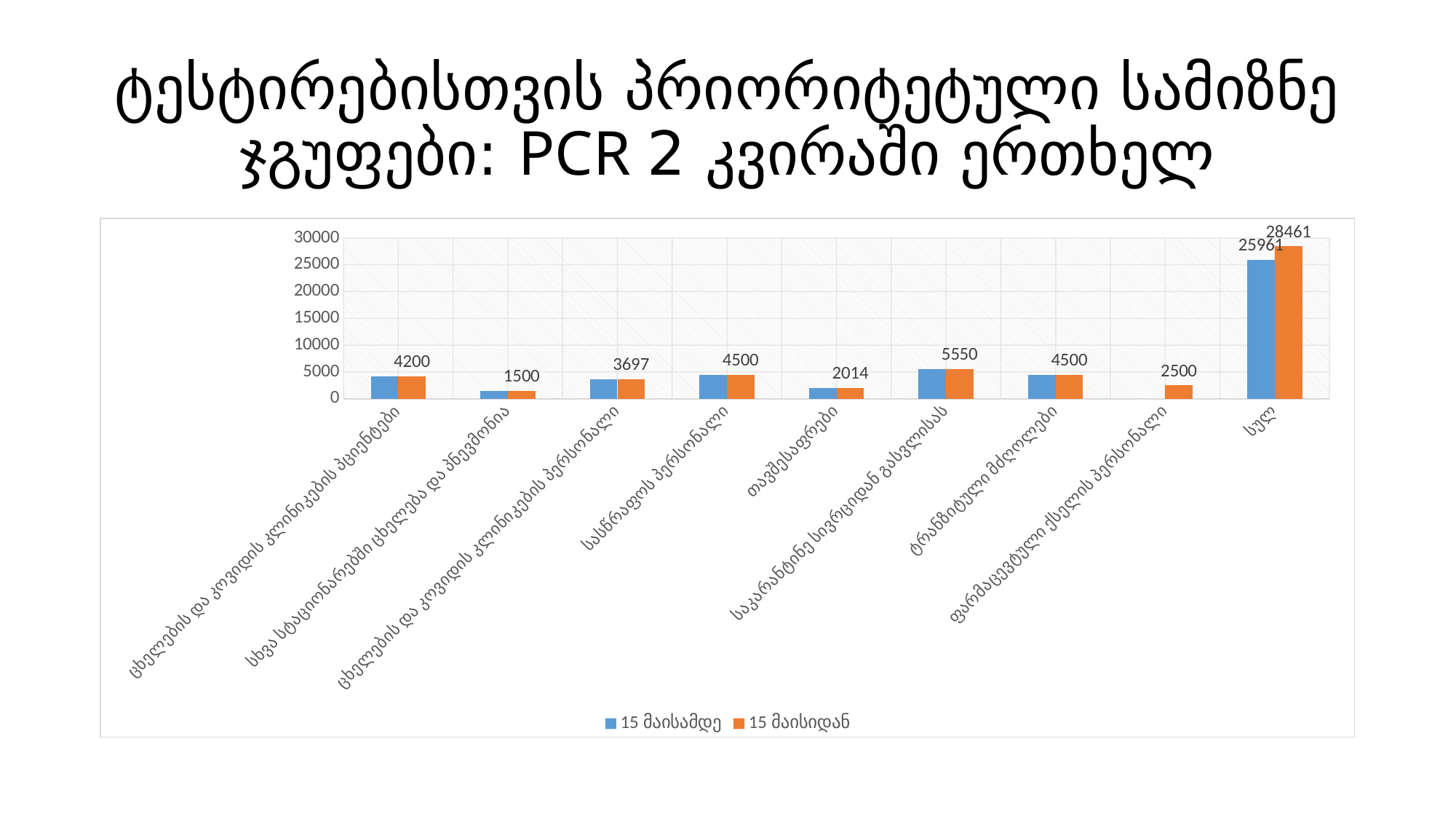
What is the labelled value for საკარანტინე სივრციდან გასვლისას? 5550 What is the value of the 15 მაისამდე series for სულ? 25961 Excluding სულ, which category has the lowest labelled value? სხვა სტაციონარებში ცხელება და პნევმონია What kind of chart is shown on the slide? bar chart What is the value of the 15 მაისიდან series for სულ? 28461 What is the labelled value for სასწრაფოს პერსონალი? 4500 How many categories are shown on the x axis? 9 What is the difference between the 15 მაისიდან and 15 მაისამდე values for სულ? 2500 What are the two series named in the legend? 15 მაისამდე and 15 მაისიდან How many series does the legend list? 2 Is the labelled value for ტრანზიტული მძღოლები greater or less than 5000? less What is the labelled value for თავშესაფრები? 2014